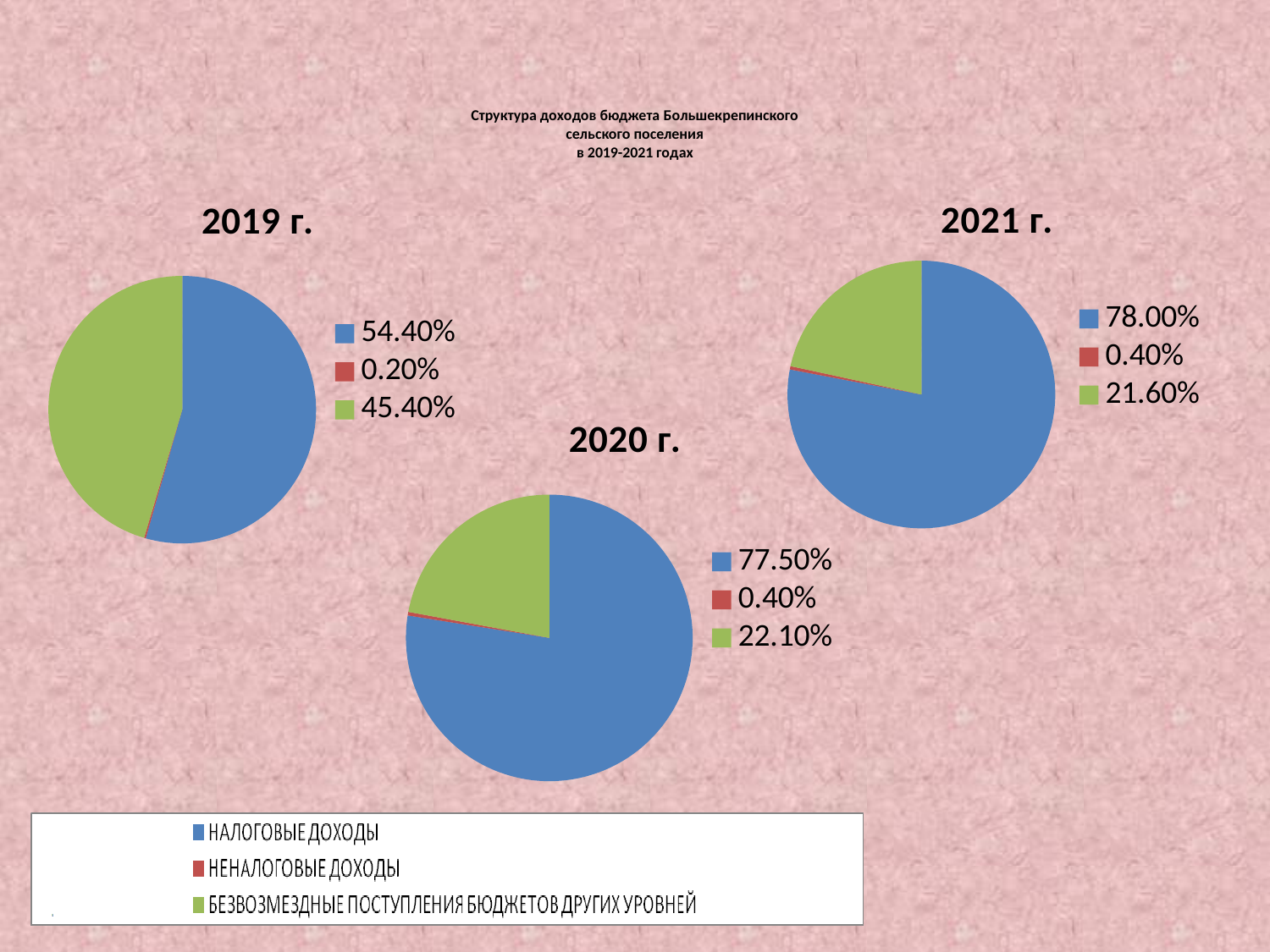
What type of chart is used for the 2019 г., 2020 г. and 2021 г. data? Pie chart In the 2021 г. pie chart, what share is shown for НАЛОГОВЫЕ ДОХОДЫ (the blue slice)? 78.00% In the 2020 г. pie chart, what share is shown for БЕЗВОЗМЕЗДНЫЕ ПОСТУПЛЕНИЯ БЮДЖЕТОВ ДРУГИХ УРОВНЕЙ (the green slice)? 22.10% In the 2019 г. pie chart, what is the difference between the shares of НАЛОГОВЫЕ ДОХОДЫ and БЕЗВОЗМЕЗДНЫЕ ПОСТУПЛЕНИЯ БЮДЖЕТОВ ДРУГИХ УРОВНЕЙ? 9.00% In the 2019 г. pie chart, what share is shown for НЕНАЛОГОВЫЕ ДОХОДЫ (the red slice)? 0.20% In the 2021 г. pie chart, which category has the largest share? НАЛОГОВЫЕ ДОХОДЫ Which colour represents НЕНАЛОГОВЫЕ ДОХОДЫ in the legend at the bottom of the slide? Red In the 2020 г. pie chart, which category has the smallest share? НЕНАЛОГОВЫЕ ДОХОДЫ How many pie charts are shown on the slide? 3 In the 2019 г. pie chart, what share is shown for НАЛОГОВЫЕ ДОХОДЫ (the blue slice)? 54.40% How many slices does the 2020 г. pie chart have? 3 Which is larger: the share of НАЛОГОВЫЕ ДОХОДЫ in the 2020 г. chart or in the 2021 г. chart? 2021 г.